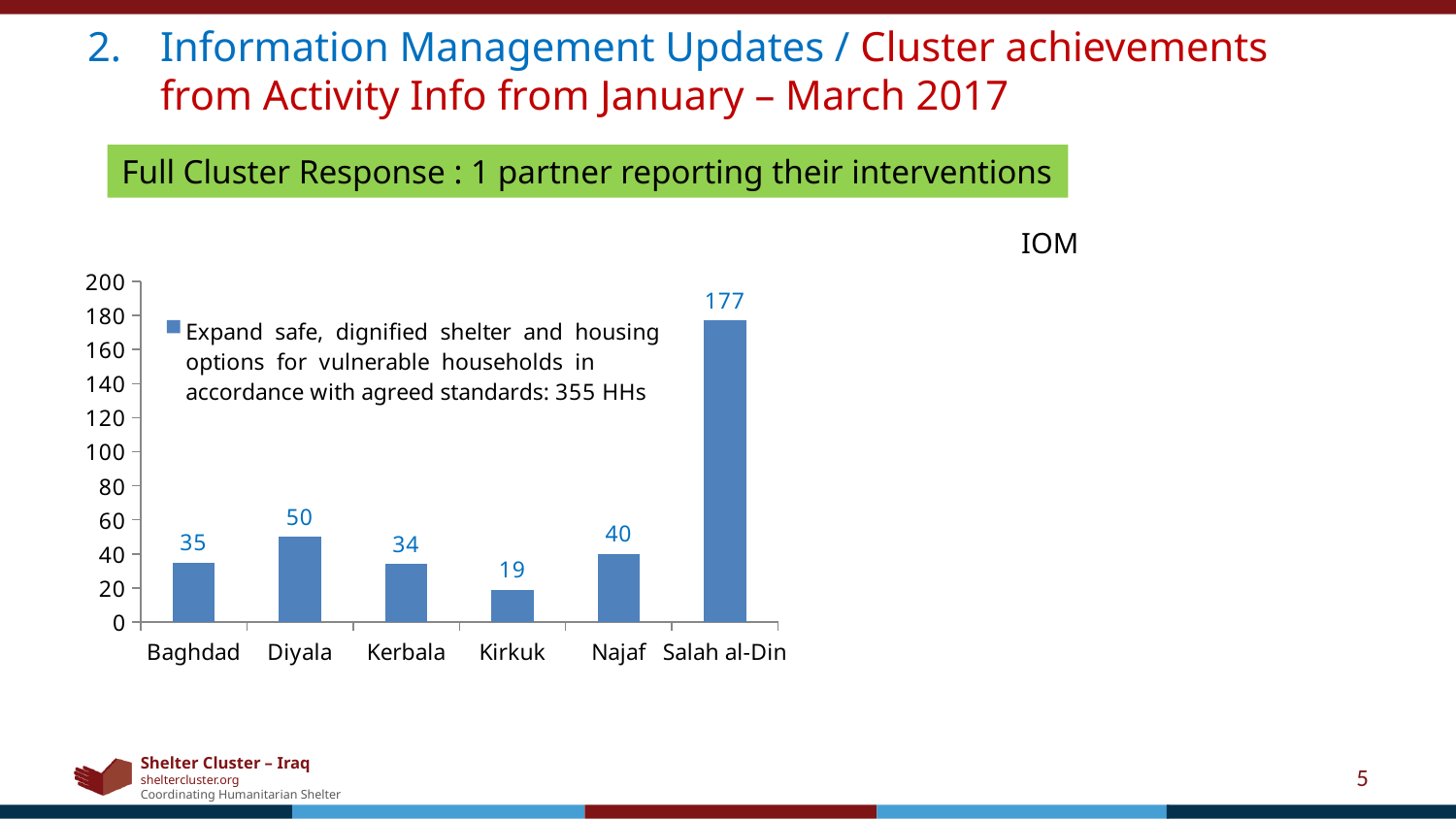
Which category has the lowest value? Kirkuk What is the value for Diyala? 50 What is the value for Kirkuk? 19 What is the difference between the values for Salah al-Din and Najaf? 137 Is the value for Salah al-Din greater or less than 160? greater How many HHs are stated in the legend entry? 355 HHs Which is larger, the value for Diyala or the value for Najaf? Diyala How many categories are shown on the x axis? 6 Which category has the highest value? Salah al-Din What is the value for Salah al-Din? 177 What kind of chart is shown on the slide? bar chart What is the difference between the values for Baghdad and Kerbala? 1